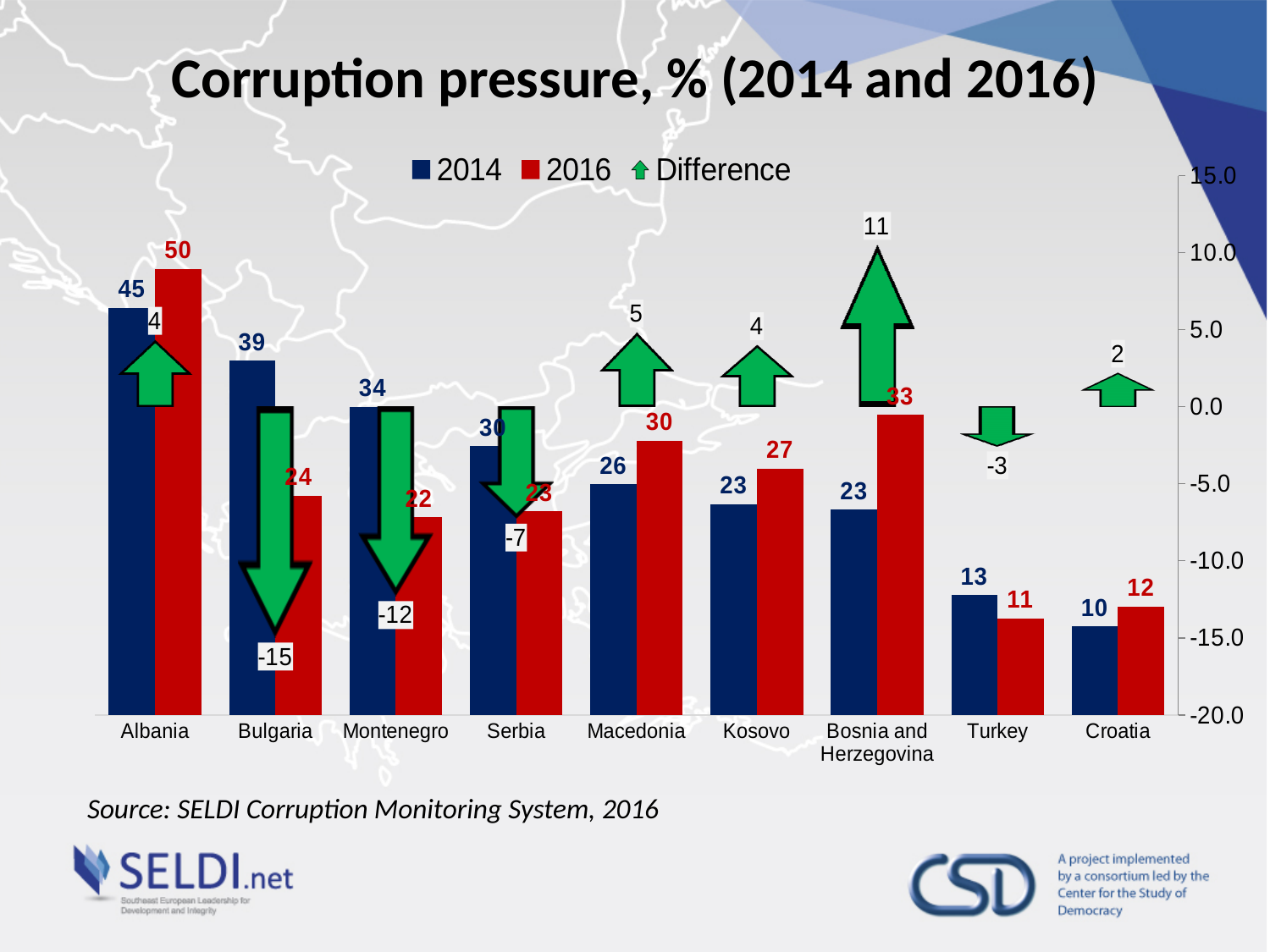
What colour are the 2016 bars? Red How many countries are shown on the chart? 9 What kind of chart is this? Bar chart What was the corruption pressure in Albania in 2016? 50 By how much did corruption pressure in Bulgaria fall from 2014 to 2016, based on the bar labels? 15 What was the corruption pressure in Bulgaria in 2014? 39 Which country had the lowest corruption pressure in 2014? Croatia What difference value is shown for Turkey? -3 Which is larger: Kosovo's 2016 value or Serbia's 2016 value? Kosovo's 2016 value Which country had the highest corruption pressure in 2016? Albania What difference value is shown for Bosnia and Herzegovina? 11 How many series does the legend list? 3